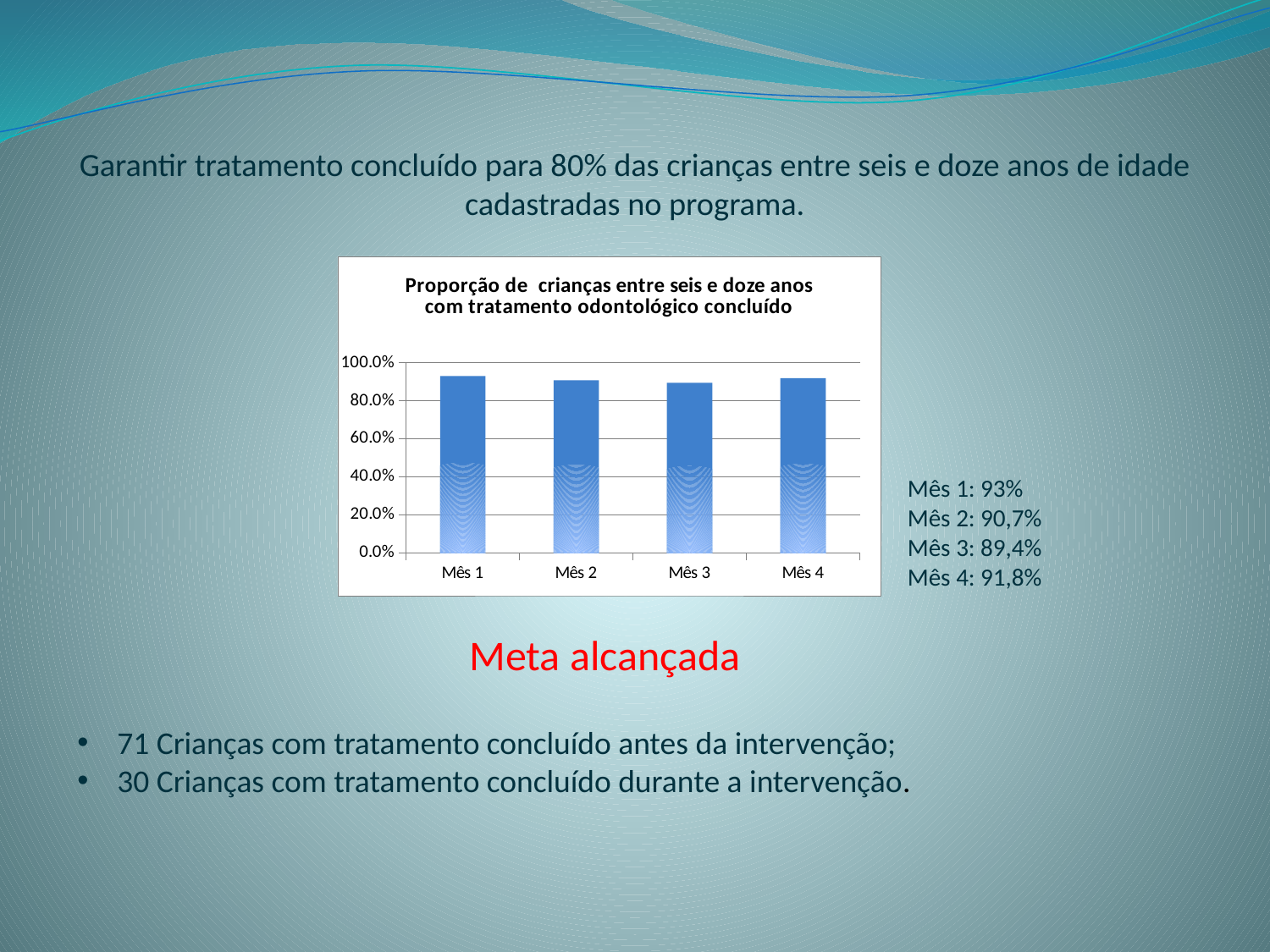
Is the value for Mês 3 greater or less than 80.0%? greater What is the value for Mês 1 in the chart? 93% Which month has the lowest proportion in the chart? Mês 3 What is the title of the chart? Proporção de crianças entre seis e doze anos com tratamento odontológico concluído What is the difference between the values for Mês 1 and Mês 3? 3,6% What kind of chart is shown on the slide? bar chart Which is larger, the value for Mês 2 or the value for Mês 4? Mês 4 How many months are shown on the x axis of the chart? 4 What is the value for Mês 4 in the chart? 91,8% Which month has the highest proportion in the chart? Mês 1 What is the value for Mês 3 in the chart? 89,4% Do the values rise or fall from Mês 1 to Mês 3? fall